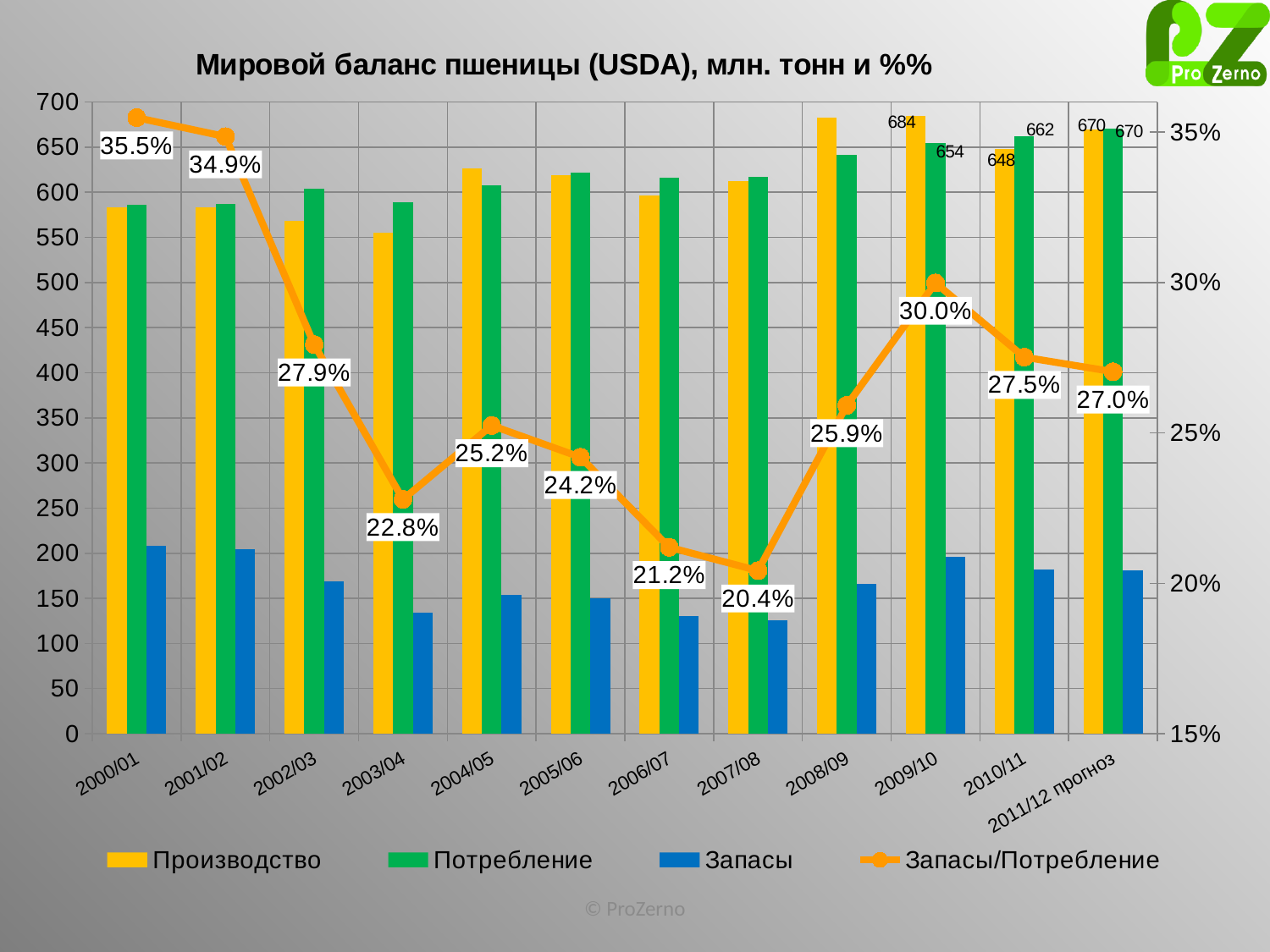
What kind of chart is this? Combined bar and line chart How many seasons are shown on the x axis? 12 In which season is Запасы/Потребление the lowest? 2007/08 Is the value of Запасы for 2007/08 greater or less than 150? less Which is larger in 2010/11, Производство or Потребление? Потребление What is the value of Производство for 2009/10? 684 Does Запасы/Потребление rise or fall from 2000/01 to 2007/08? fall In which season is Запасы/Потребление the highest? 2000/01 What is the value of Запасы/Потребление for 2007/08? 20.4% What is the difference between Производство and Потребление in 2009/10? 30 How many series does the legend list? 4 What is the value of Потребление for 2010/11? 662